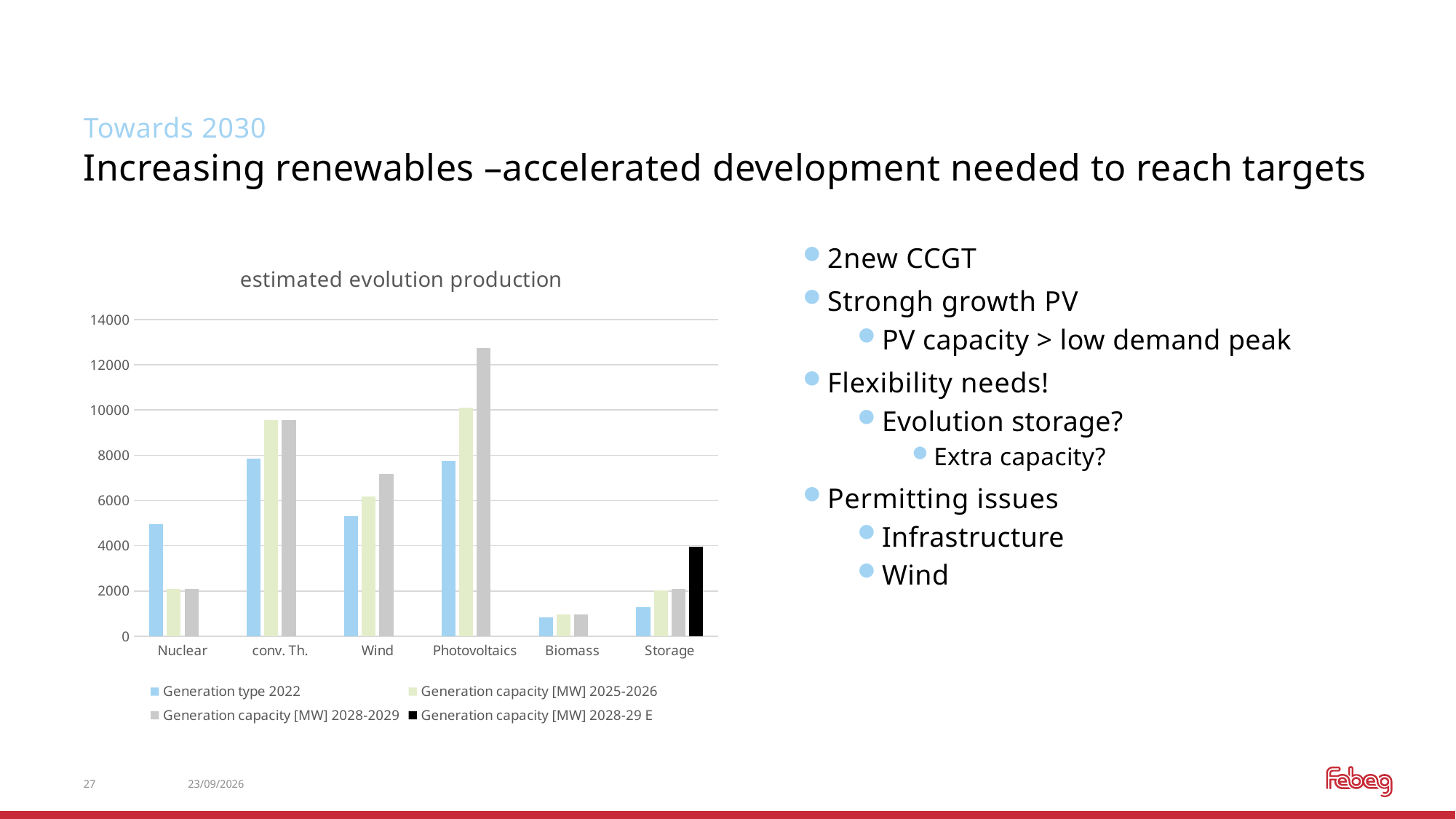
How many categories are shown on the x axis of the chart? 6 For Generation capacity [MW] 2028-2029, which is larger: Wind or conv. Th.? conv. Th. Is the value for Biomass in Generation type 2022 greater or less than 2000? less How many series does the chart's legend list? 4 Which category has the highest value for Generation capacity [MW] 2028-2029? Photovoltaics Which category has the lowest value for Generation type 2022? Biomass Is the value for Nuclear in Generation type 2022 greater or less than 4000? greater What kind of chart is shown on the slide? bar chart For Nuclear, which is larger: Generation type 2022 or Generation capacity [MW] 2025-2026? Generation type 2022 Which category is the only one with a bar for Generation capacity [MW] 2028-29 E? Storage Is the value for Photovoltaics in Generation capacity [MW] 2028-2029 greater or less than 12000? greater What is the title of the chart? estimated evolution production